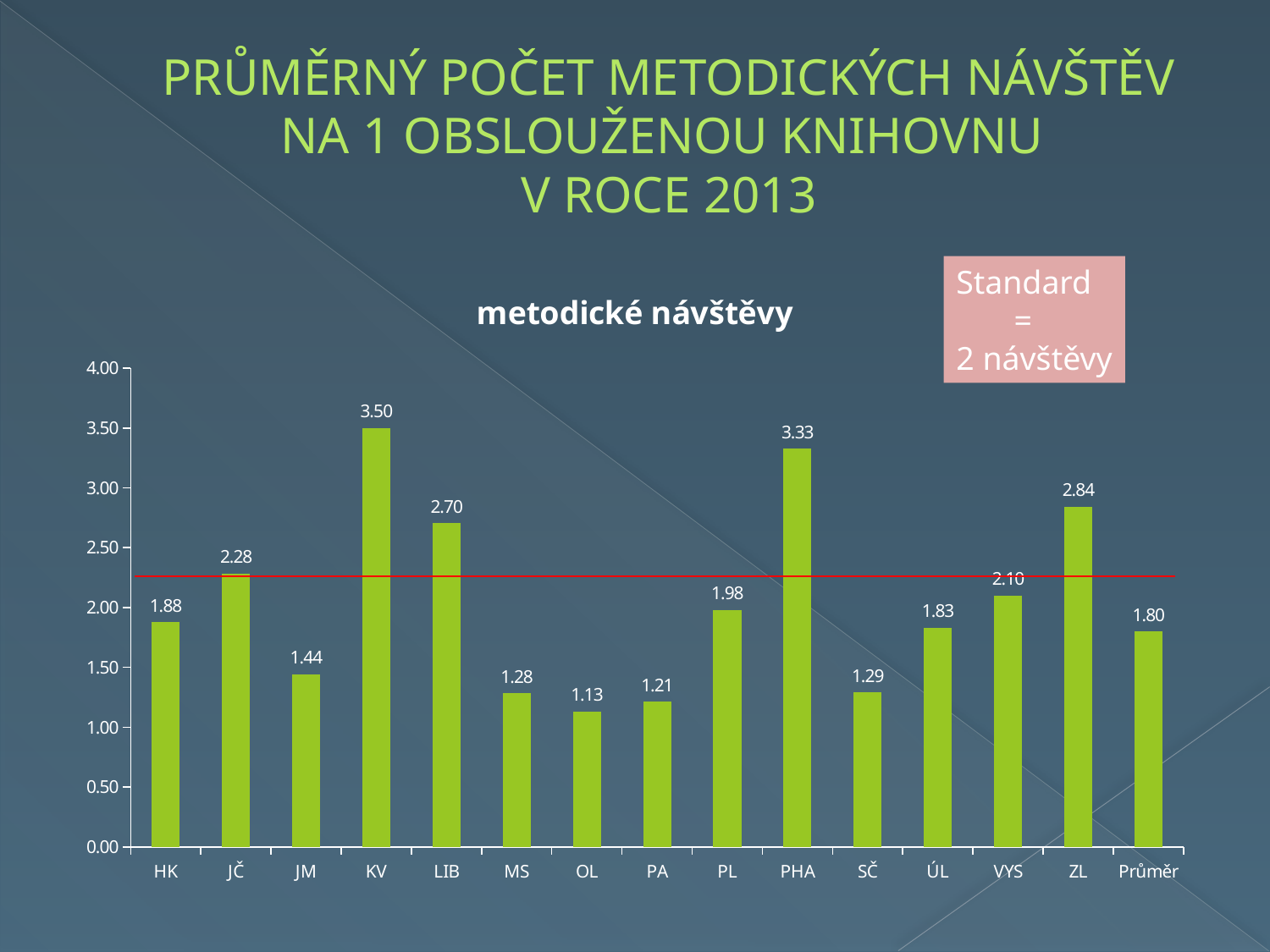
Which category has the highest value? KV Is the value for JM greater or less than 1.50? less What kind of chart is shown on the slide? bar chart What is the title of the chart? metodické návštěvy Which is larger, the value for LIB or the value for ZL? ZL What is the value for PHA? 3.33 How many categories are shown on the x axis? 15 What is the difference between the values for KV and PHA? 0.17 What is the value for KV? 3.50 What is the value for Průměr? 1.80 Which category has the lowest value? OL What is the value for OL? 1.13